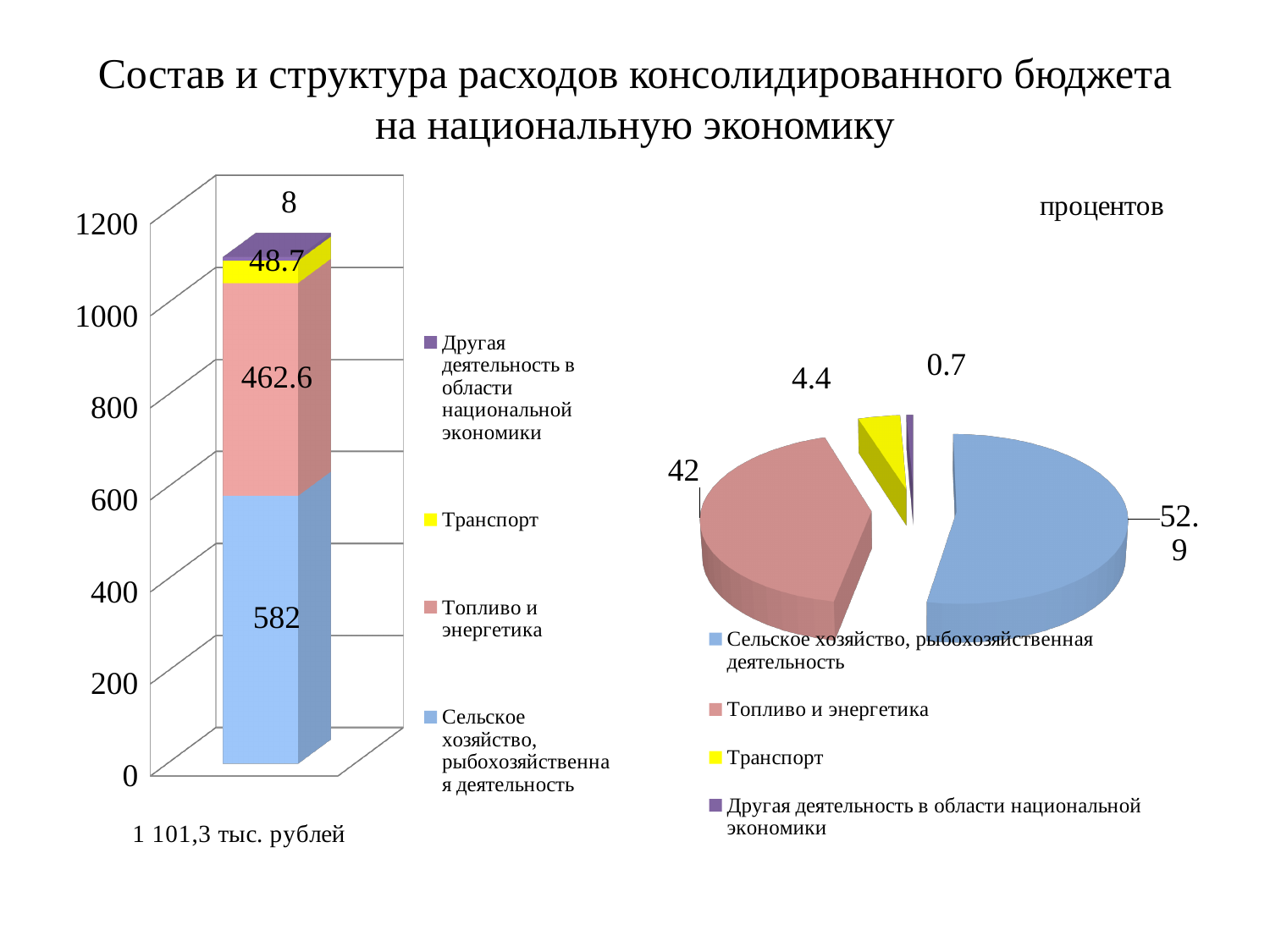
In the stacked bar chart on the left, what is the value for Другая деятельность в области национальной экономики? 8 In the stacked bar chart on the left, what is the value for Топливо и энергетика? 462.6 In the stacked bar chart on the left, what is the difference between the values for Сельское хозяйство, рыбохозяйственная деятельность and Топливо и энергетика? 119.4 What kind of chart is the chart on the left of the slide? Stacked bar chart In the pie chart on the right, what share does Сельское хозяйство, рыбохозяйственная деятельность have? 52.9 In the stacked bar chart on the left, what is the value for Транспорт? 48.7 In the pie chart on the right, which category has the smallest share? Другая деятельность в области национальной экономики In the stacked bar chart on the left, how many series does the legend list? 4 In the pie chart on the right, what share does Топливо и энергетика have? 42 In the pie chart on the right, which is larger: the share for Транспорт or the share for Другая деятельность в области национальной экономики? Транспорт In the stacked bar chart on the left, what is the value for Сельское хозяйство, рыбохозяйственная деятельность? 582 In the stacked bar chart on the left, which series has the largest value? Сельское хозяйство, рыбохозяйственная деятельность